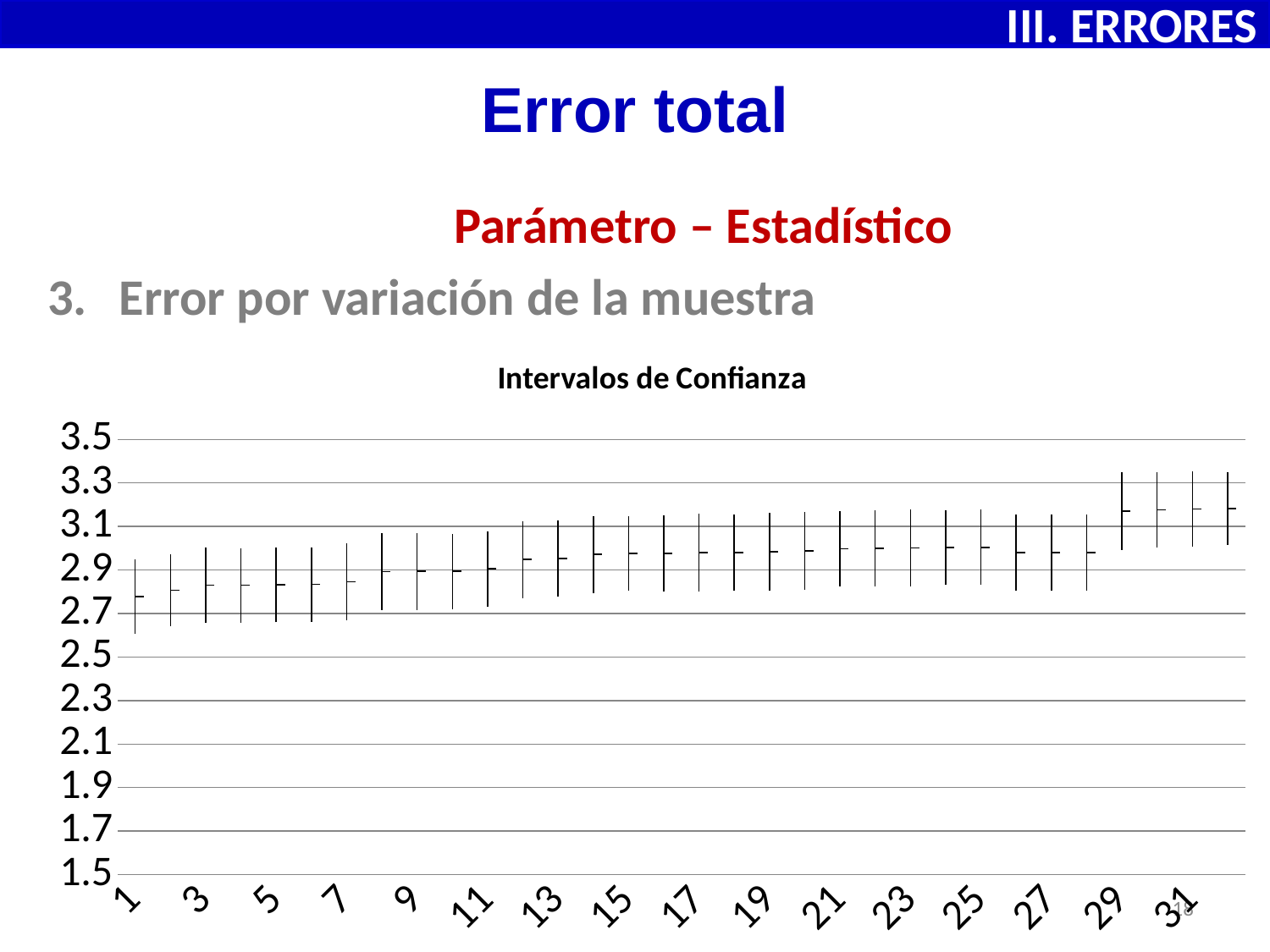
Is the midpoint value for category 30 greater or less than 2.9? greater How many category labels are printed along the x axis of the chart? 16 Is the lowest point of the interval for category 1 greater or less than 2.5? greater Is the highest point of the interval for category 31 greater or less than 2.9? greater What is the lowest value shown on the y axis of the chart? 1.5 What kind of chart is shown on the slide? high-low (stock) chart What is the title of the chart? Intervalos de Confianza Do the interval values generally rise or fall from left to right along the x axis? rise Which has the larger midpoint value, category 1 or category 31? 31 What is the highest value shown on the y axis of the chart? 3.5